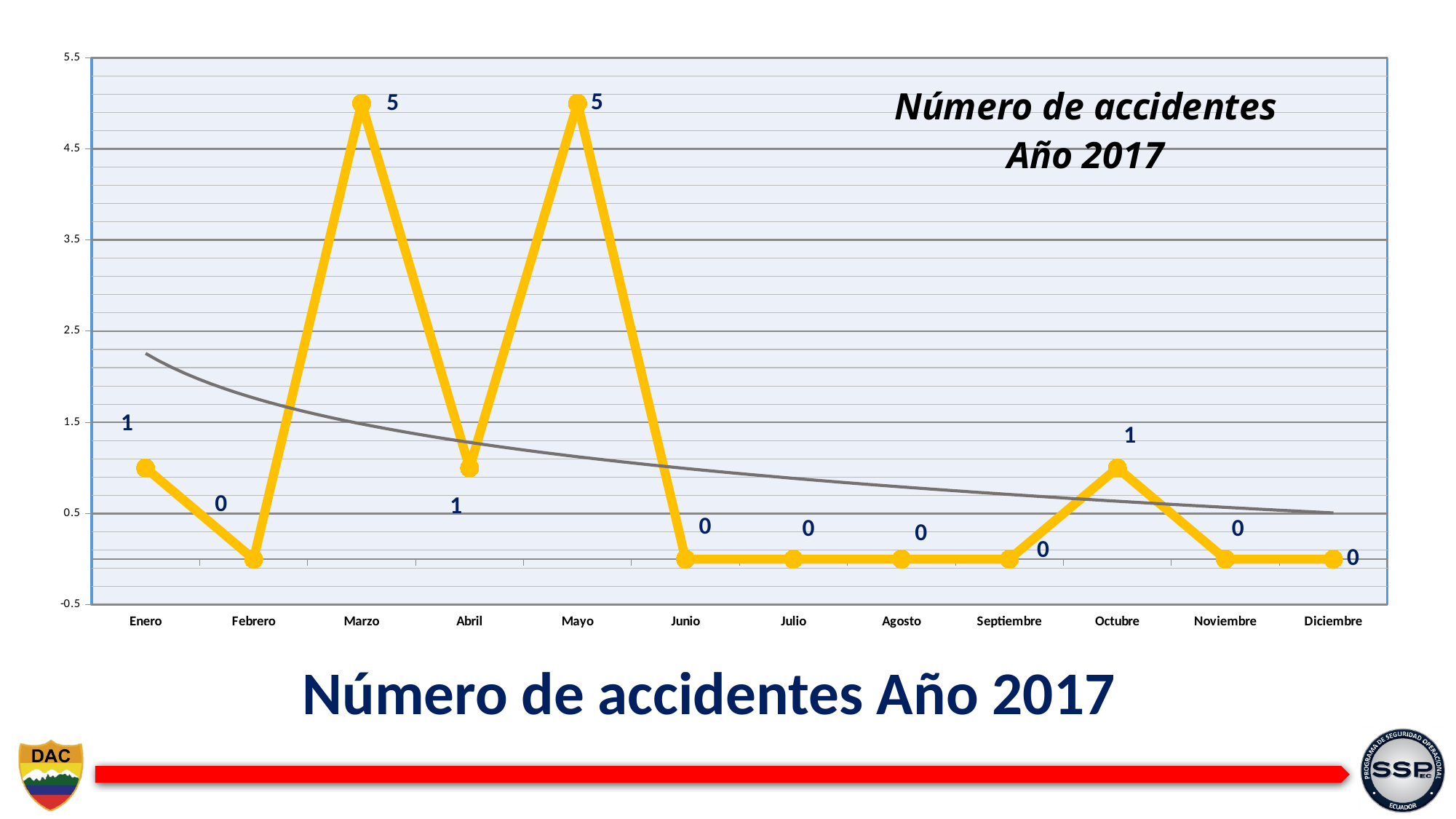
What is the number of accidents for Octubre? 1 Does the number of accidents rise or fall from Mayo to Junio? fall Is the value for Marzo greater or less than 4.5? greater How many months are plotted on the x axis of the chart? 12 What is the title of the chart? Número de accidentes Año 2017 Which has a larger value, Enero or Mayo? Mayo Which months have the highest number of accidents? Marzo and Mayo What kind of chart is shown on the slide? line chart What is the number of accidents for Marzo? 5 What is the difference between the values for Mayo and Octubre? 4 What is the difference between the values for Marzo and Abril? 4 What is the number of accidents for Agosto? 0